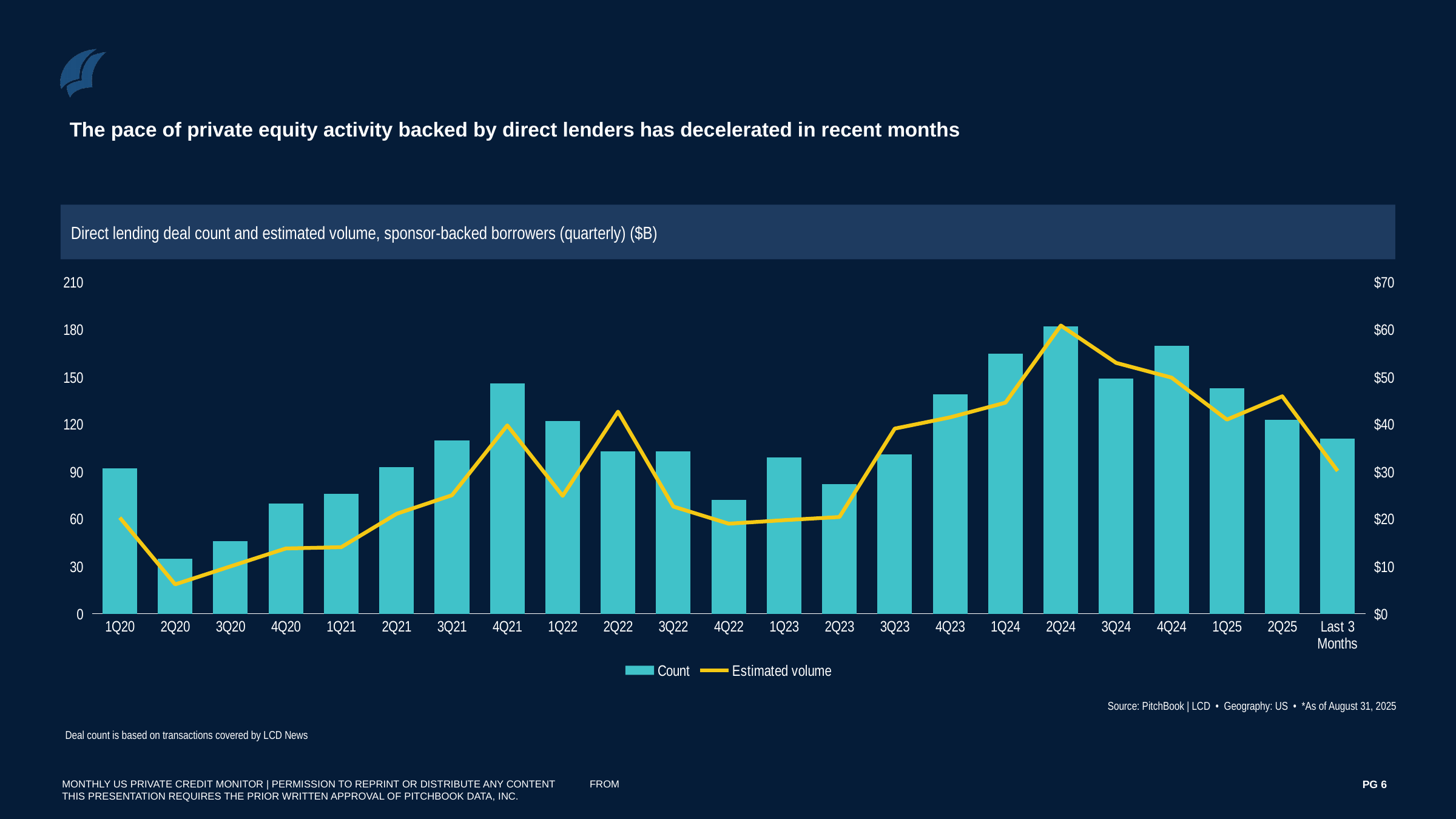
Is the Estimated volume for 2Q20 greater or less than $10? less Which period has the highest deal count bar? 2Q24 What kind of chart is shown on the slide? A combination bar and line chart Does the deal count rise or fall from 4Q24 to Last 3 Months? fall Which period has the lowest deal count bar? 2Q20 How many series does the legend list? 2 How many periods are shown along the x axis? 23 In which period does the Estimated volume line reach its peak? 2Q24 What are the two series named in the legend? Count and Estimated volume Is the deal count for 2Q20 greater or less than 60? less Is the deal count for 2Q24 greater or less than 150? greater Which period has the larger deal count, 4Q21 or 1Q22? 4Q21